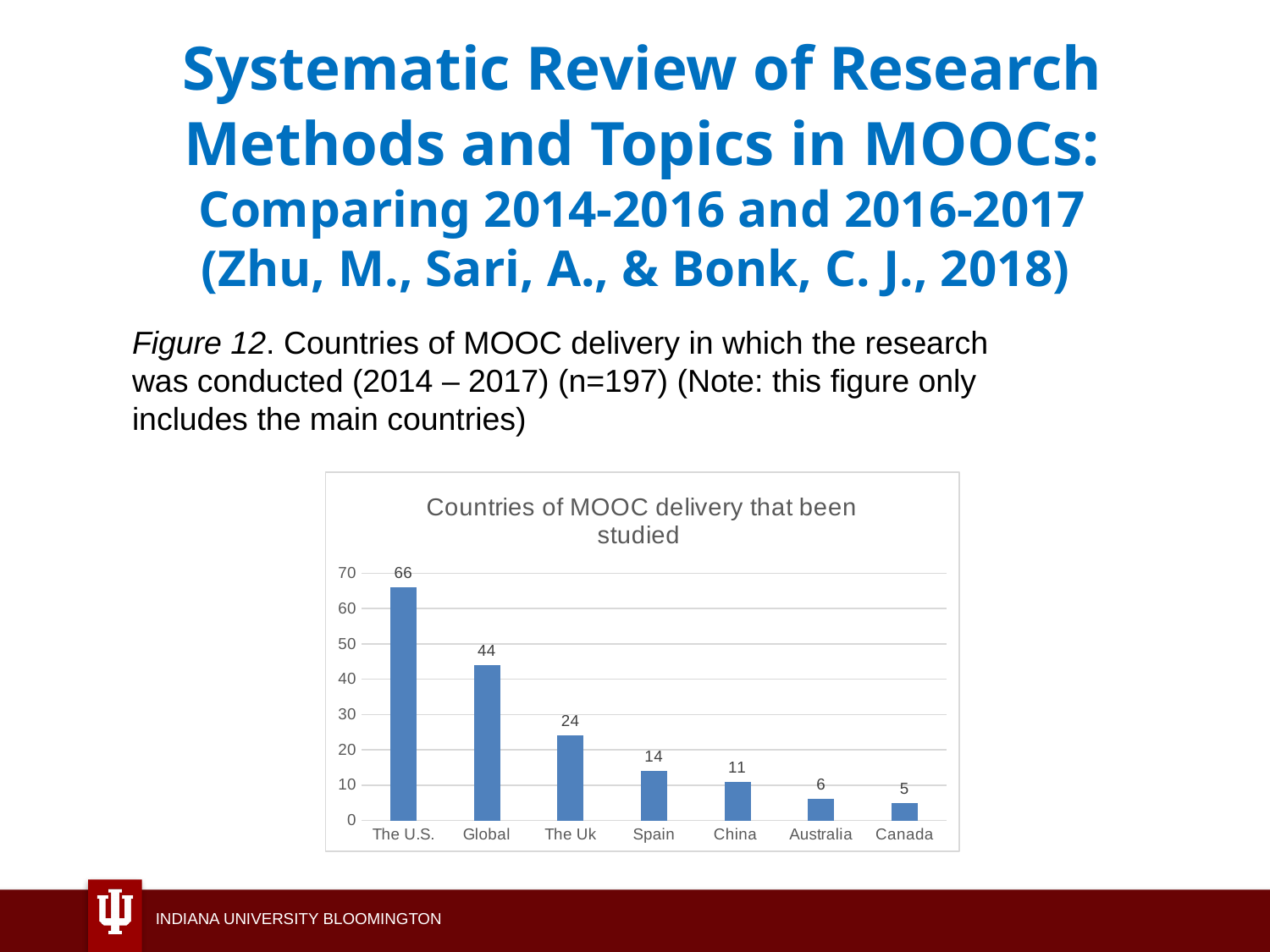
Which is larger, the value for Spain or the value for China? Spain Which category has the lowest value? Canada What is the difference between the values for The Uk and China? 13 What is the value for Australia? 6 What is the value for Spain? 14 How many categories are shown on the x axis? 7 Is the value for Global greater or less than 40? greater What is the value for The U.S.? 66 What is the difference between the values for The U.S. and Global? 22 What is the title of the chart? Countries of MOOC delivery that been studied Which category has the highest value? The U.S. What kind of chart is this? bar chart